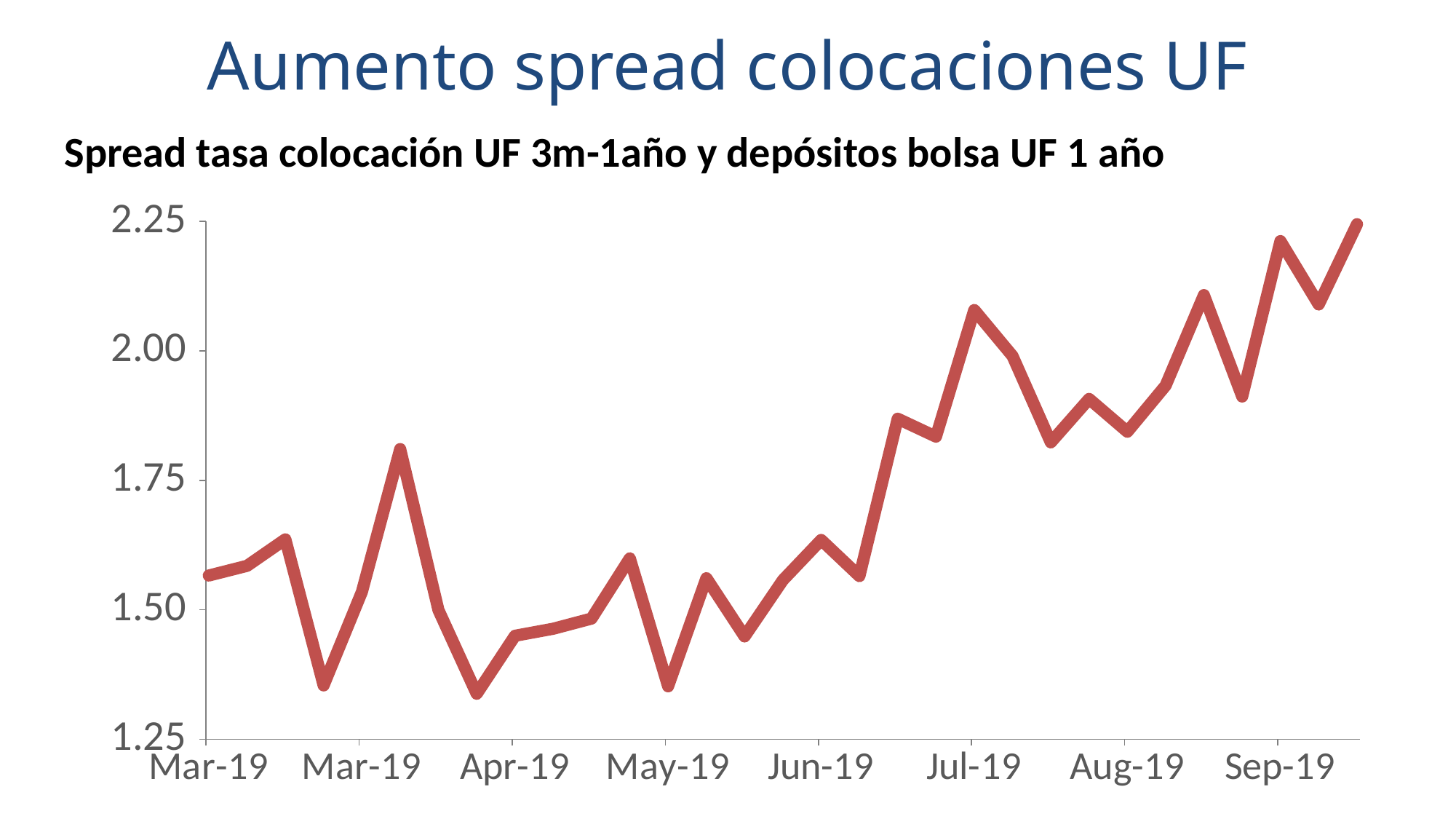
Is the value at the Aug-19 tick greater or less than 1.75? greater What is the subtitle printed above the chart? Spread tasa colocación UF 3m-1año y depósitos bolsa UF 1 año Overall, do the values rise or fall from Mar-19 to Sep-19? rise Is the value at the Apr-19 tick greater or less than 1.50? less Is the value at the May-19 tick greater or less than 1.50? less Which is larger, the value at the Jul-19 tick or the value at the Apr-19 tick? Jul-19 What is the title of the slide? Aumento spread colocaciones UF How many lines (series) are plotted on the chart? 1 What kind of chart is shown on the slide? line chart